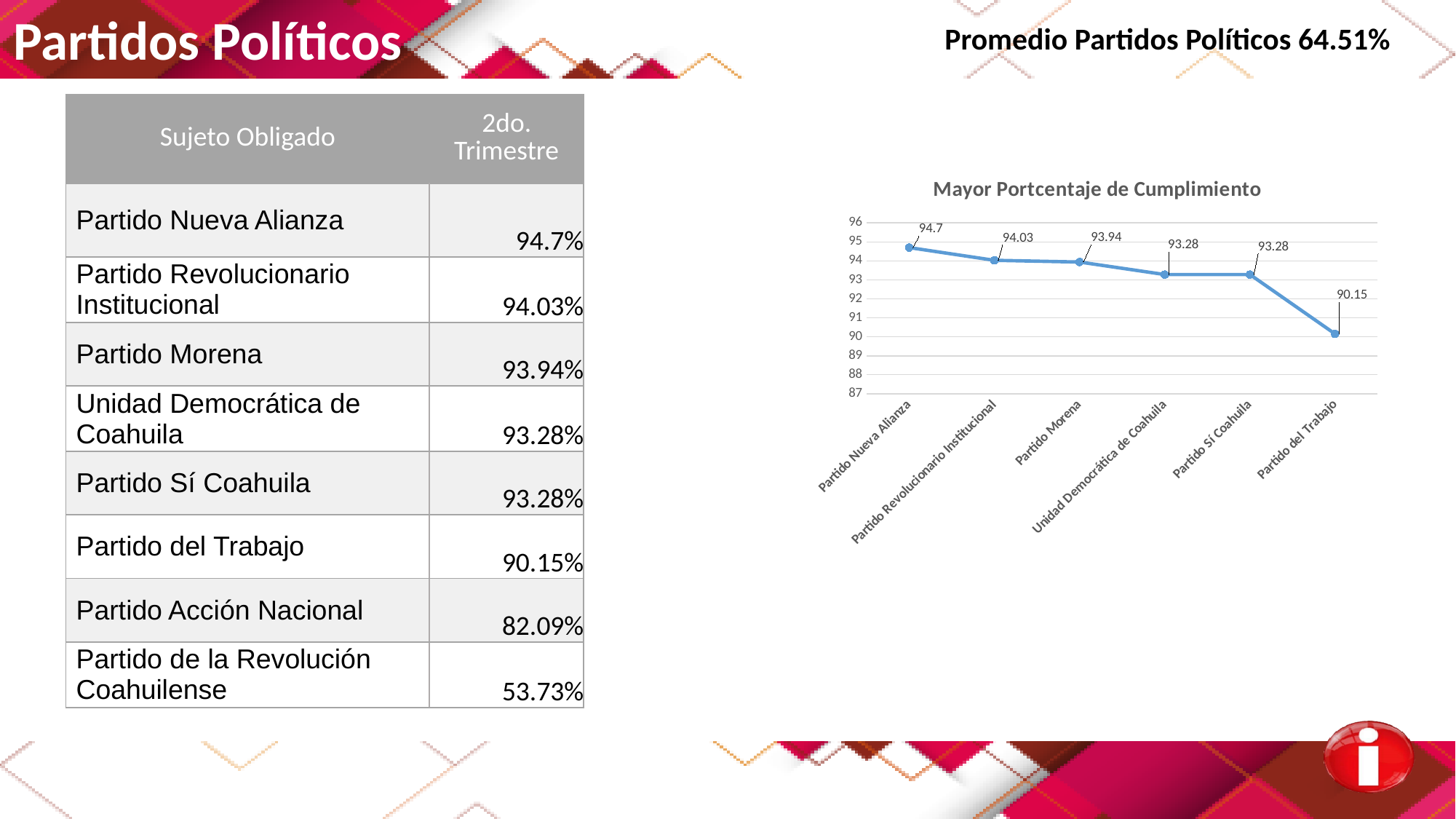
What is the value for Partido Nueva Alianza in the chart? 94.7 What is the difference between the values for Partido Revolucionario Institucional and Partido Morena? 0.09 What is the value for Partido del Trabajo in the chart? 90.15 What is the title of the chart? Mayor Portcentaje de Cumplimiento Which category has the lowest value in the chart? Partido del Trabajo What kind of chart is shown on the slide? line chart What is the value for Partido Morena in the chart? 93.94 Which category has the highest value in the chart? Partido Nueva Alianza What is the difference between the values for Partido Nueva Alianza and Partido del Trabajo? 4.55 How many categories are plotted in the chart? 6 Is the value for Partido del Trabajo greater or less than 91? less Which is larger, the value for Partido Morena or the value for Partido Sí Coahuila? Partido Morena